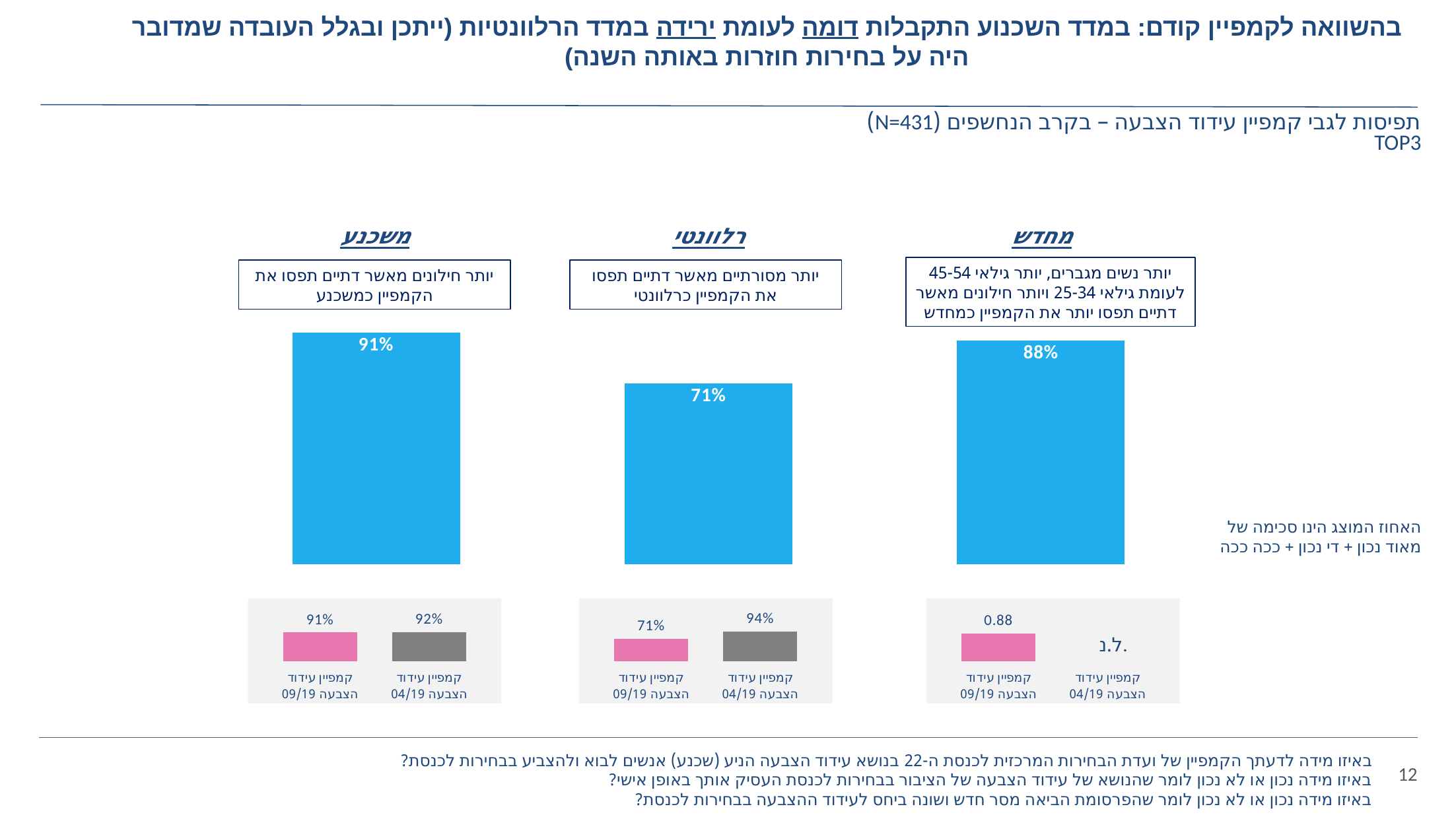
What kind of chart is used to show the values for משכנע, רלוונטי and מחדש? bar chart What is the difference between the large blue bar values for משכנע and רלוונטי? 20% Among the three large blue bars (משכנע, רלוונטי, מחדש), which has the highest value? משכנע In the small comparison chart under משכנע, what is the value for קמפיין עידוד הצבעה 04/19? 92% How many large blue bars are shown on the slide? 3 What is the value of the large blue bar for מחדש? 88% In the small comparison chart under רלוונטי, what is the value for קמפיין עידוד הצבעה 04/19? 94% In the small comparison chart under רלוונטי, which is larger: the value for 09/19 or the value for 04/19? 04/19 What is the value of the large blue bar for רלוונטי? 71% Among the three large blue bars (משכנע, רלוונטי, מחדש), which has the lowest value? רלוונטי In the small comparison chart under מחדש, what is shown for קמפיין עידוד הצבעה 04/19? ל.נ What is the value of the large blue bar for משכנע? 91%